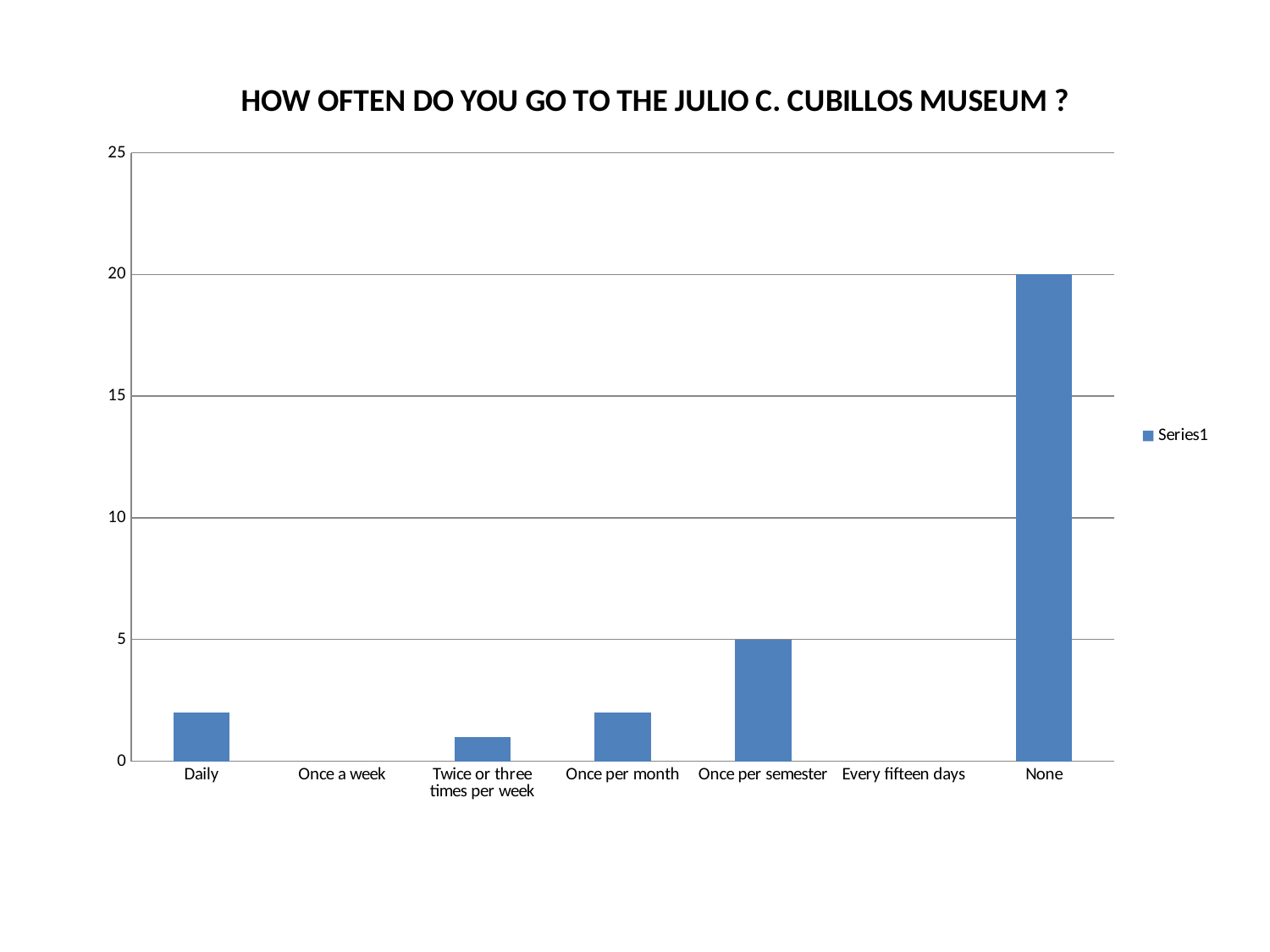
Which category has the highest value? None What is the value for None? 20 What is the value for Once per semester? 5 How many series does the legend list? 1 Is the value for Twice or three times per week greater or less than 5? less What is the difference between the values for None and Once per semester? 15 Is the value for Daily greater or less than 5? less What kind of chart is shown on the slide? bar chart How many categories are shown on the x axis? 7 What is the title of the chart? HOW OFTEN DO YOU GO TO THE JULIO C. CUBILLOS MUSEUM ? Is the value for None greater or less than 15? greater Which is larger, the value for None or the value for Once per semester? None